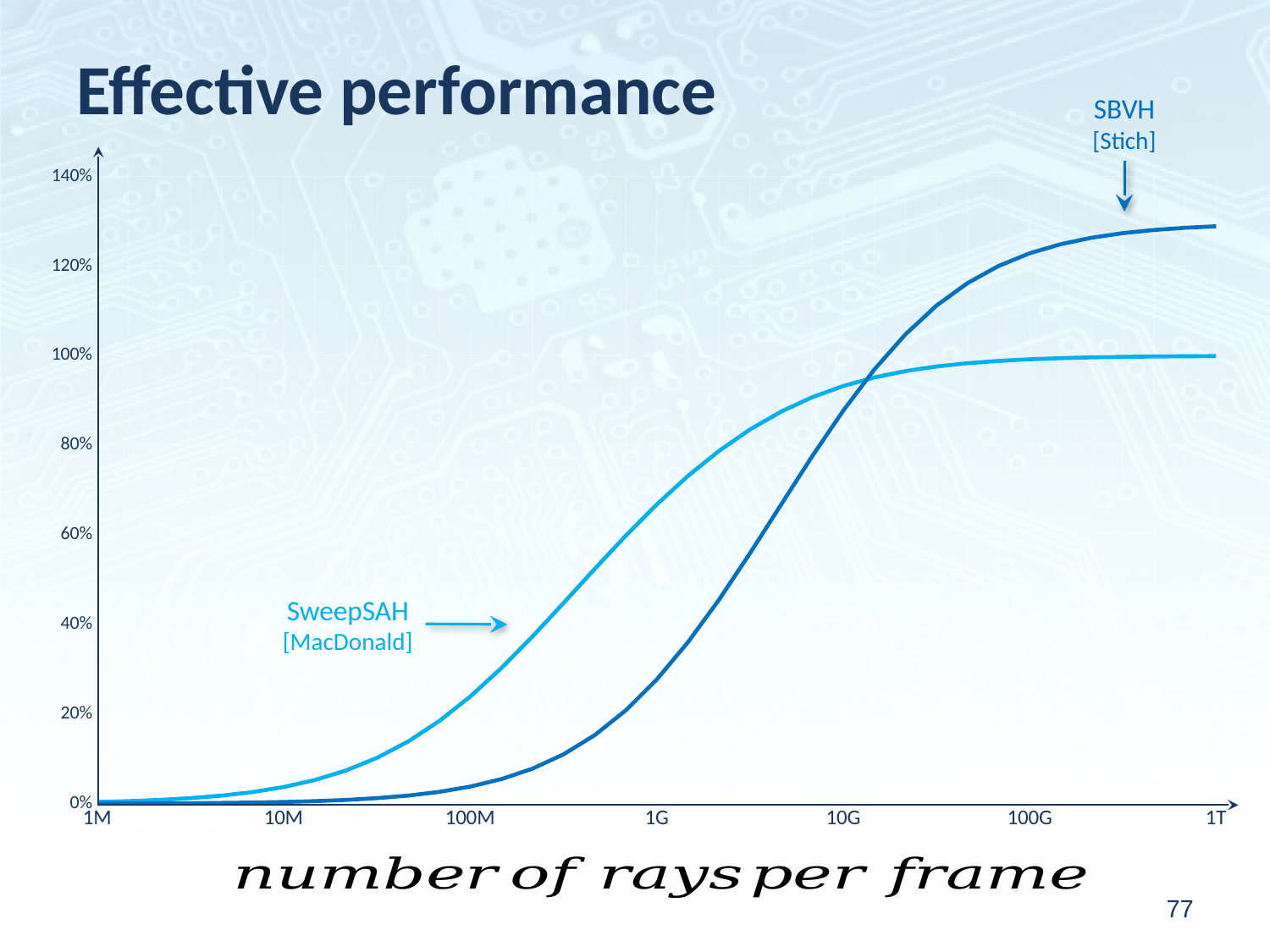
Is the value of SBVH [Stich] at 1T rays per frame greater or less than 120%? greater How many series (curves) are plotted on the chart? 2 At 1G rays per frame, which series has the higher value, SweepSAH [MacDonald] or SBVH [Stich]? SweepSAH [MacDonald] Is the value of SBVH [Stich] at 100M rays per frame greater or less than 20%? less What is the label of the x axis? number of rays per frame Does the SweepSAH [MacDonald] curve rise or fall as the number of rays per frame increases? rise At 1T rays per frame, which series has the higher value, SweepSAH [MacDonald] or SBVH [Stich]? SBVH [Stich] Which series reaches the highest value on the chart? SBVH [Stich] Does the SBVH [Stich] curve rise or fall as the number of rays per frame increases? rise How many tick labels are shown on the x axis? 7 What kind of chart is shown on the slide? line chart What is the title of the chart on the slide? Effective performance